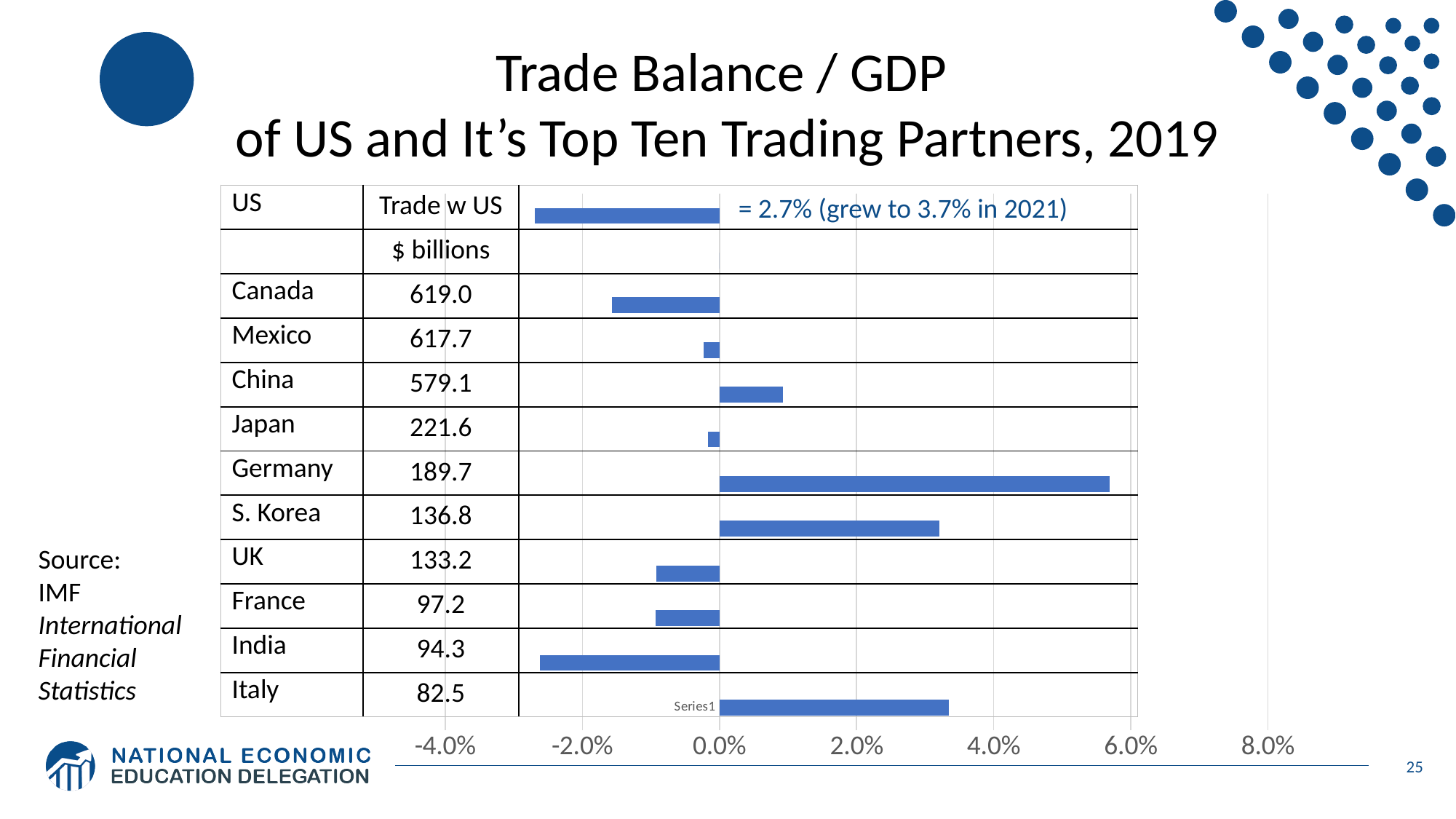
Is the value for S. Korea greater or less than 2.0%? greater Which is larger, the value for Germany or the value for S. Korea? Germany Is the value for China greater or less than 0.0%? greater What is the highest value shown on the chart's horizontal axis? 8.0% How many bars (countries including the US) are plotted on the chart? 11 Which country has the highest trade balance / GDP bar on the chart? Germany What kind of chart is shown on the slide? bar chart Is the value for India greater or less than -2.0%? less Which is larger, the value for China or the value for Canada? China